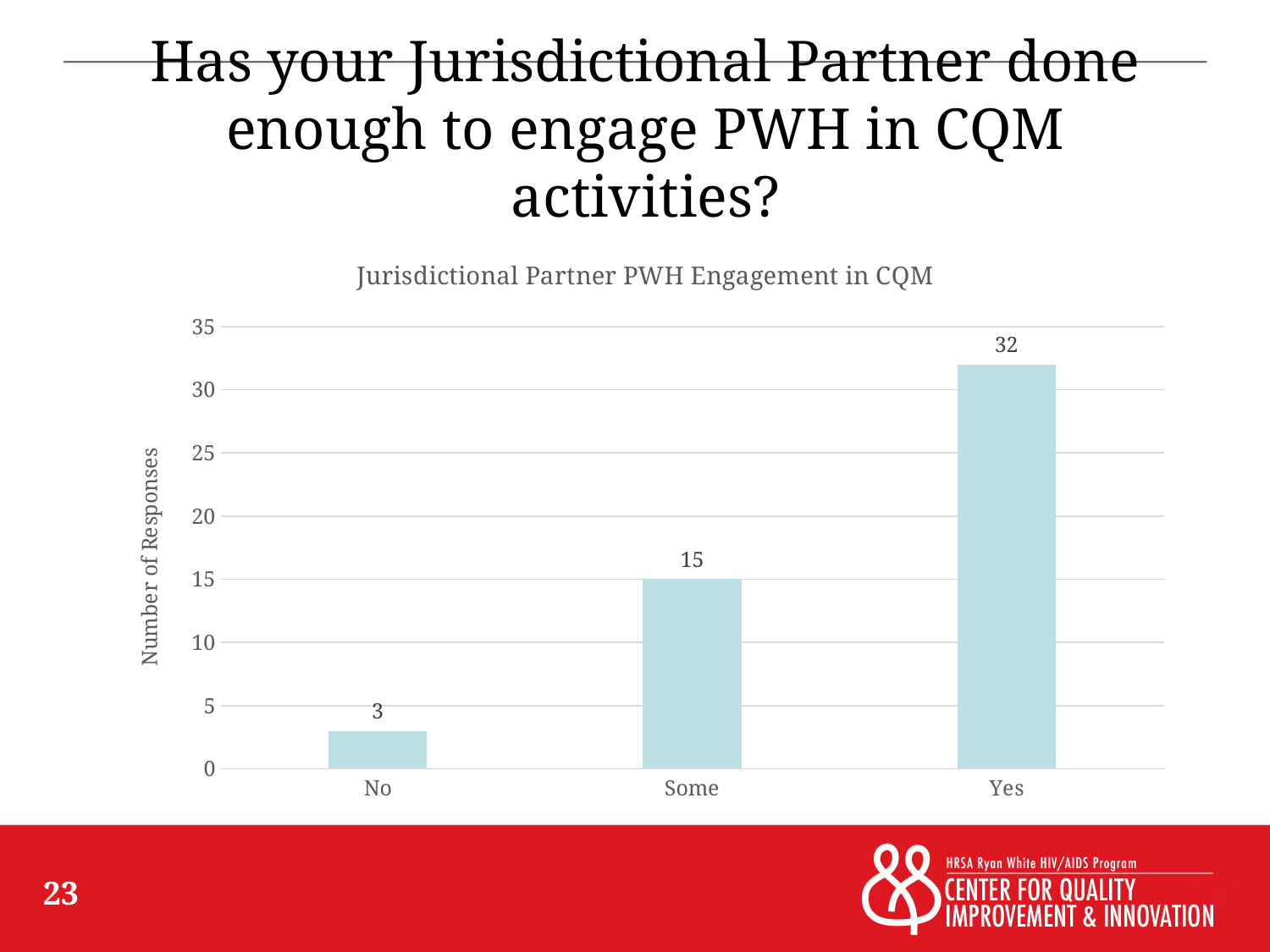
What is the difference in responses between "Yes" and "Some"? 17 What kind of chart is shown on the slide? Bar chart What is the number of responses for "Yes"? 32 Which category has the lowest number of responses? No How many categories are shown on the x axis? 3 What is the title of the chart? Jurisdictional Partner PWH Engagement in CQM Which has more responses, "Some" or "No"? Some What is the number of responses for "No"? 3 Which category has the highest number of responses? Yes What is the difference in responses between "Some" and "No"? 12 What is the number of responses for "Some"? 15 Is the value for "Yes" greater or less than 30? greater